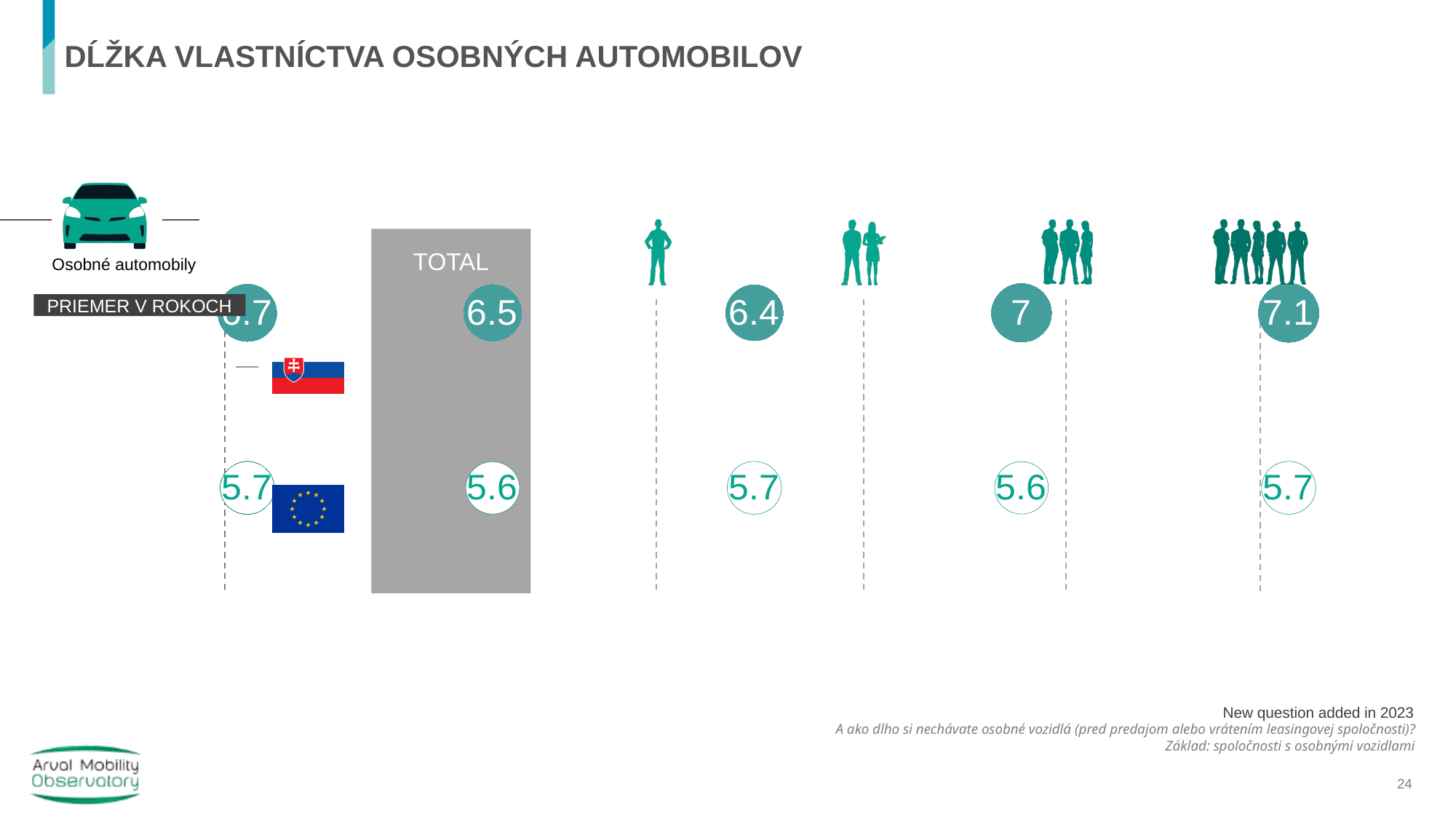
Is the TOTAL value larger in the Slovak row or in the EU row? Slovak row What unit is indicated by the label 'PRIEMER V ROKOCH' for the values on the slide? Average in years In the top (Slovak flag) row, what value is shown under the column with five person icons? 7.1 In the bottom (EU flag) row, what value is shown under the column with three person icons? 5.6 What is the TOTAL value shown in the top (Slovak flag) row? 6.5 In the top (Slovak flag) row, what value is shown under the column with three person icons? 7 What is the TOTAL value shown in the bottom (EU flag) row? 5.6 What is the difference between the TOTAL value in the Slovak row (6.5) and the TOTAL value in the EU row (5.6)? 0.9 Which column has the highest value in the top (Slovak flag) row? The column with five person icons (7.1)